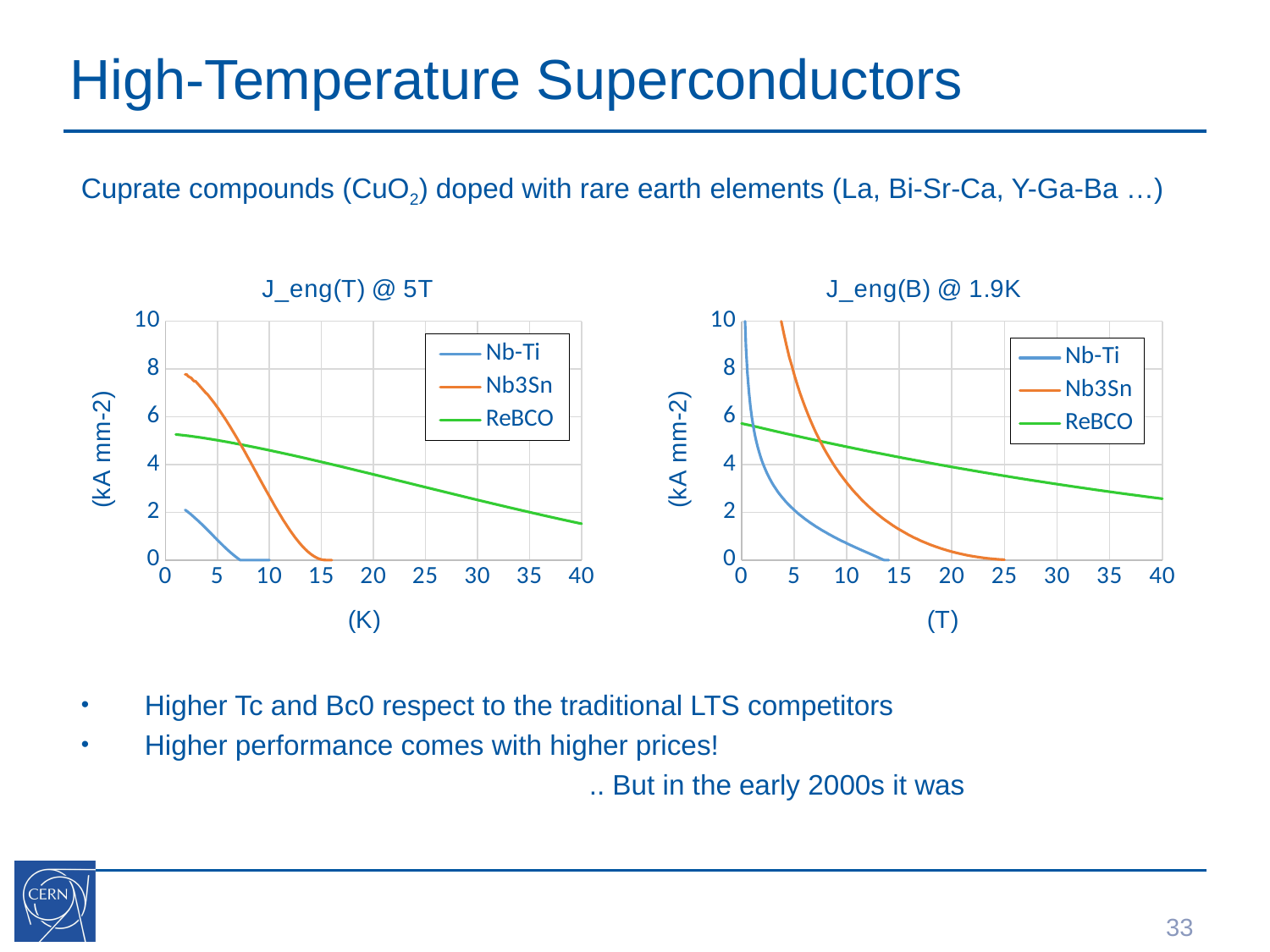
In the chart titled J_eng(B) @ 1.9K, is the value of Nb-Ti at 5 T greater or less than 4? less In the chart titled J_eng(T) @ 5T, does the ReBCO curve rise or fall as temperature increases? fall In the chart titled J_eng(B) @ 1.9K, what is the label of the x axis? (T) In the chart titled J_eng(T) @ 5T, is the value of ReBCO at 40 K greater or less than 2? less In the chart titled J_eng(T) @ 5T, is the value of Nb3Sn at 2 K greater or less than 6? greater In the chart titled J_eng(T) @ 5T, which series are listed in the legend? Nb-Ti, Nb3Sn, ReBCO In the chart titled J_eng(B) @ 1.9K, which series has the larger value at 20 T, Nb3Sn or ReBCO? ReBCO What kind of chart is the chart titled J_eng(T) @ 5T? line chart In the chart titled J_eng(B) @ 1.9K, does the Nb3Sn curve rise or fall as the field increases? fall In the chart titled J_eng(T) @ 5T, which series has the larger value at 10 K, Nb3Sn or ReBCO? ReBCO How many series does the legend of the chart titled J_eng(B) @ 1.9K list? 3